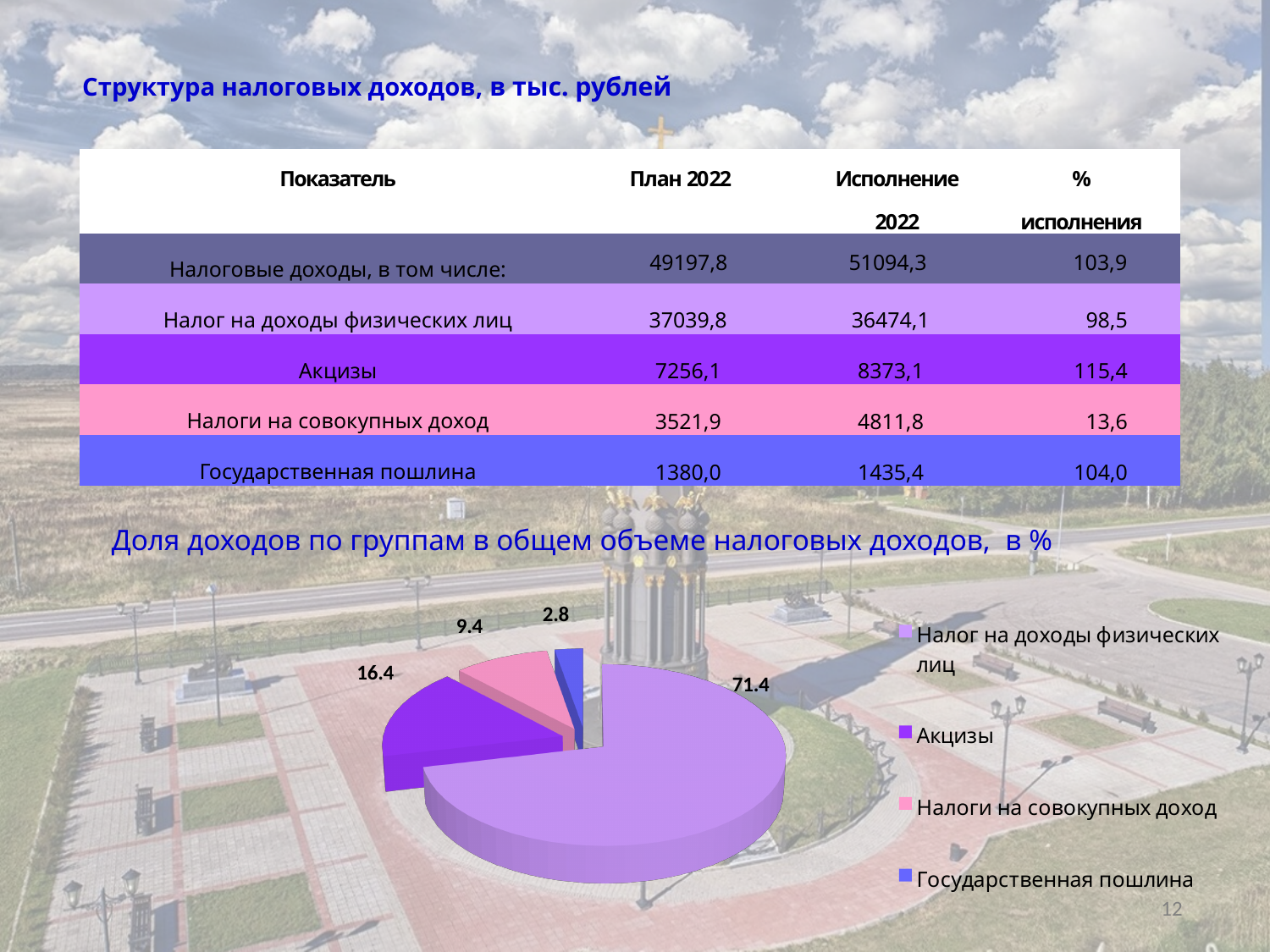
How many entries does the legend of the pie chart list? 4 What is the share for Налог на доходы физических лиц in the pie chart? 71.4 What is the share for Акцизы in the pie chart? 16.4 What is the share for Государственная пошлина in the pie chart? 2.8 What is the title of the pie chart? Доля доходов по группам в общем объеме налоговых доходов, в % How many slices does the pie chart have? 4 What is the share for Налоги на совокупных доход in the pie chart? 9.4 Which is larger in the pie chart: the share of Акцизы or the share of Государственная пошлина? Акцизы Which category has the largest slice in the pie chart? Налог на доходы физических лиц What is the difference between the shares of Акцизы and Налоги на совокупных доход in the pie chart? 7.0 Which category has the smallest slice in the pie chart? Государственная пошлина What type of chart is shown on the slide? Pie chart